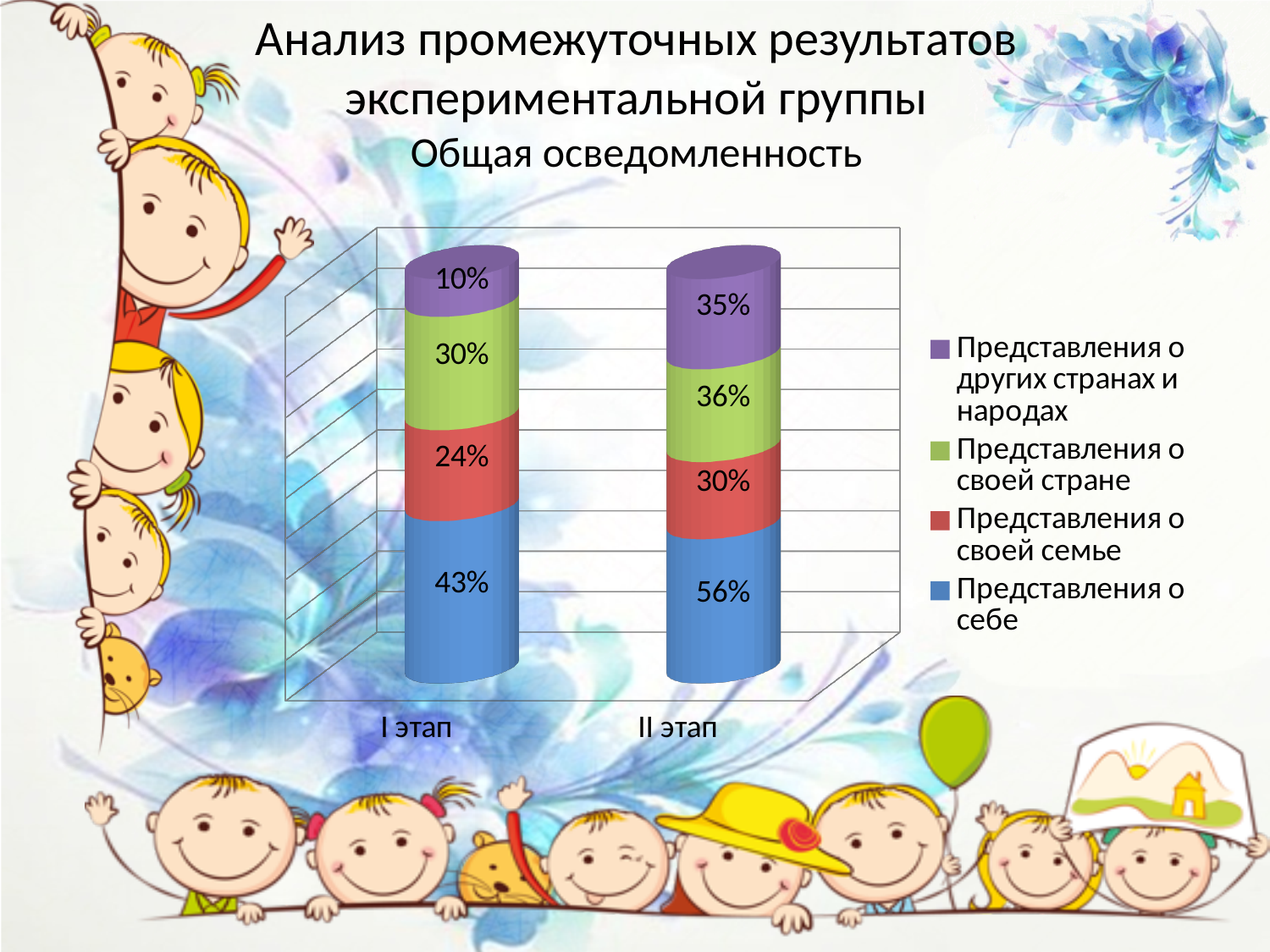
What is the value for "Представления о своей семье" at I этап? 24% Which series has the highest value at II этап? Представления о себе What is the value for "Представления о себе" at II этап? 56% How many series does the legend list? 4 What is the value for "Представления о своей стране" at II этап? 36% What is the difference between the values for "Представления о других странах и народах" at II этап and I этап? 25% What kind of chart is shown on the slide? Stacked bar chart How many categories are shown on the x axis? 2 Which series has the lowest value at I этап? Представления о других странах и народах Which is larger: "Представления о своей семье" at I этап or at II этап? II этап What is the value for "Представления о других странах и народах" at I этап? 10% What is the value for "Представления о себе" at I этап? 43%